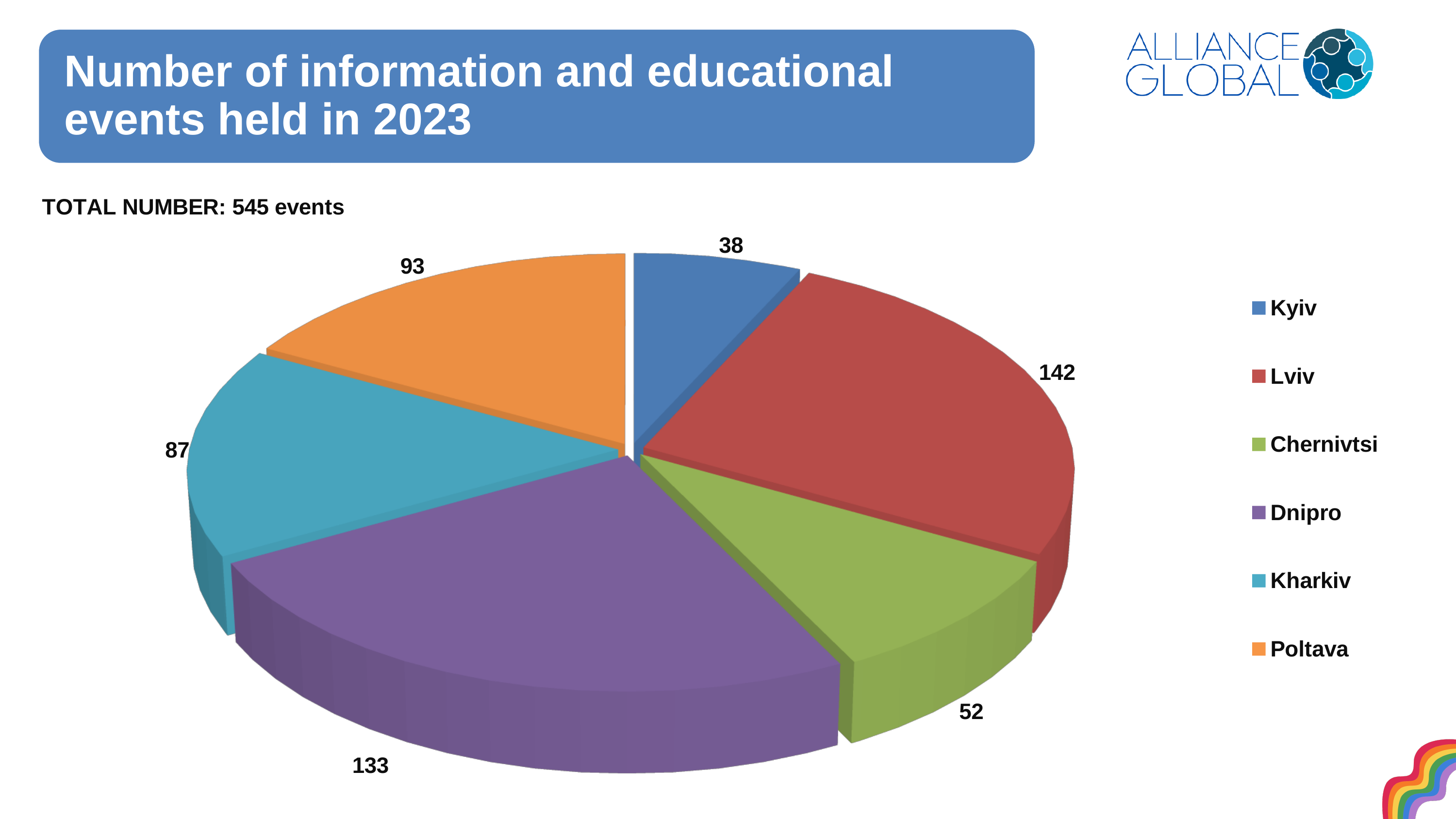
What is the difference between the number of events in Poltava and Kharkiv? 6 What is the difference between the number of events in Lviv and Dnipro? 9 How many events were held in Poltava? 93 How many events were held in Kyiv? 38 Which city held the fewest events? Kyiv Which city held the most events? Lviv What is the total number of events stated on the slide? 545 events How many events were held in Lviv? 142 Which city held more events, Chernivtsi or Kharkiv? Kharkiv How many events were held in Dnipro? 133 How many cities are shown in the pie chart? 6 What type of chart is shown on the slide? Pie chart